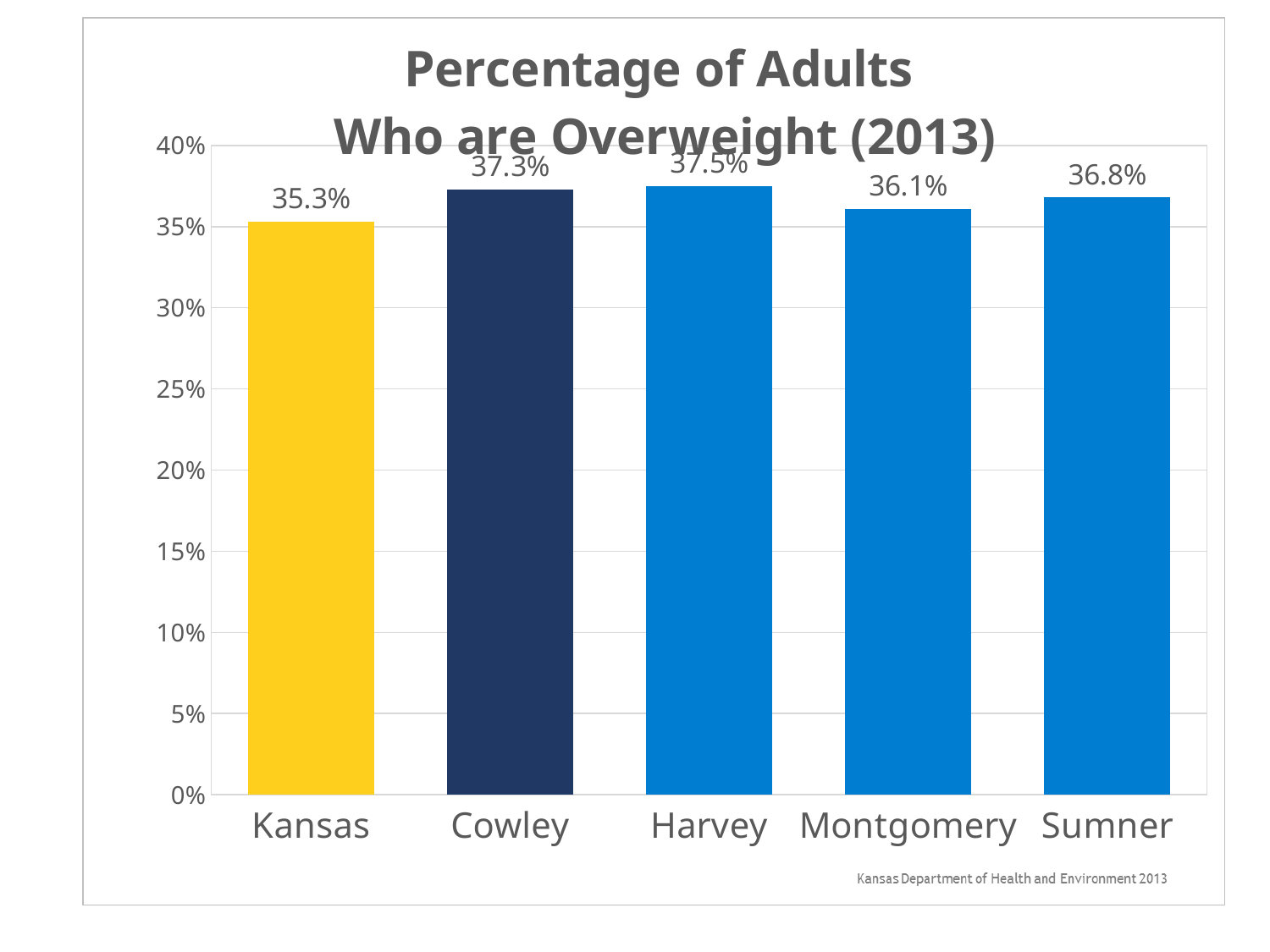
Which category has the lowest percentage of overweight adults? Kansas What is the percentage of adults who are overweight in Cowley? 37.3% What is the percentage of adults who are overweight in Montgomery? 36.1% What is the title of the chart? Percentage of Adults Who are Overweight (2013) What is the percentage of adults who are overweight in Sumner? 36.8% What is the difference between the percentages for Harvey and Kansas? 2.2% What is the percentage of adults who are overweight in Kansas? 35.3% Which has a higher percentage of overweight adults, Cowley or Montgomery? Cowley Which category has the highest percentage of overweight adults? Harvey What kind of chart is shown on the slide? Bar chart How many categories are shown on the chart? 5 What is the difference between the percentages for Sumner and Montgomery? 0.7%